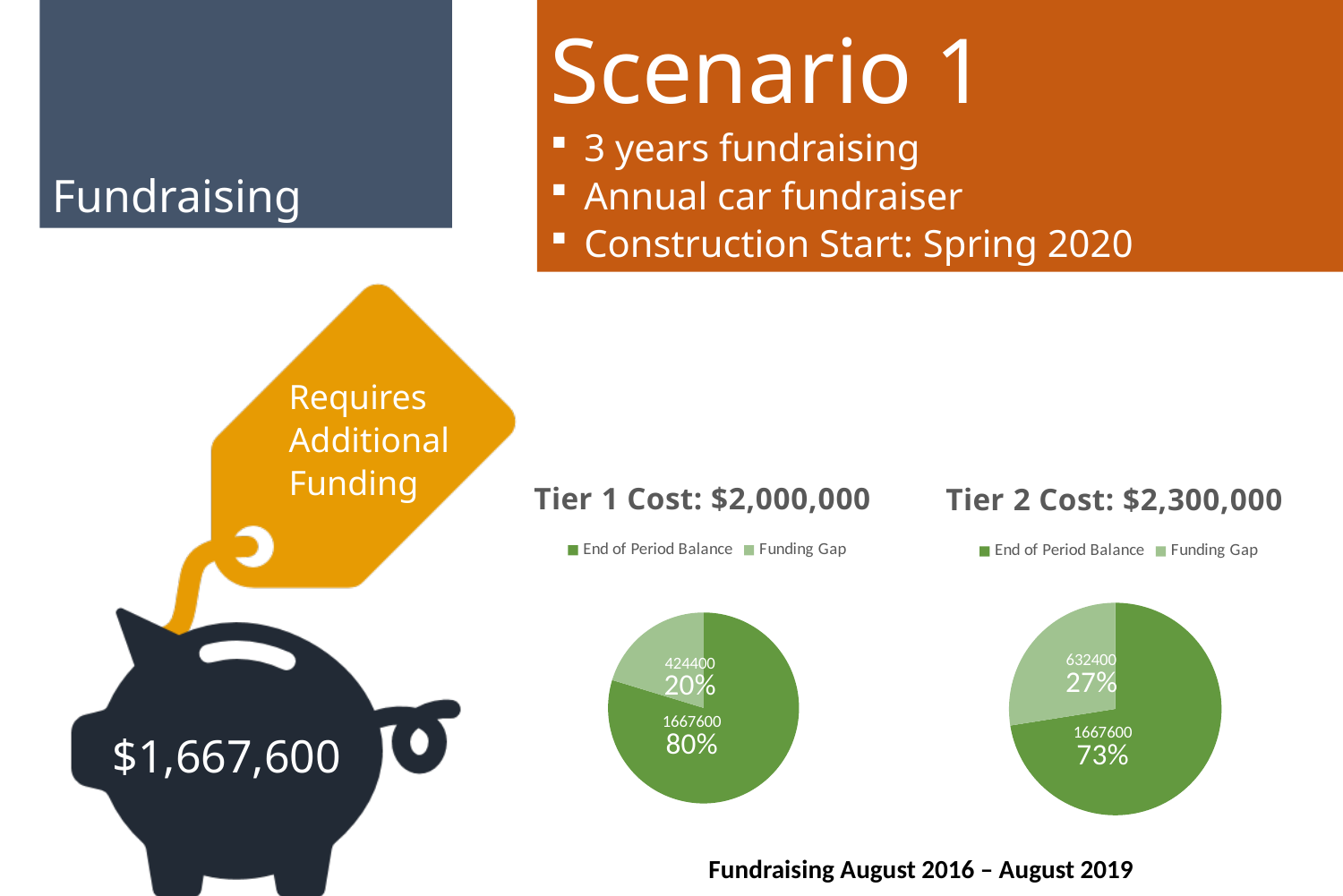
What kind of chart is the Tier 1 Cost: $2,000,000 chart? Pie chart In the Tier 2 Cost: $2,300,000 chart, which slice is the smallest? Funding Gap How many series does the legend of the Tier 2 Cost: $2,300,000 chart list? 2 What is the difference between the Funding Gap values in the Tier 2 Cost: $2,300,000 chart and the Tier 1 Cost: $2,000,000 chart? 208000 In the Tier 1 Cost: $2,000,000 chart, which slice is the largest? End of Period Balance In the Tier 2 Cost: $2,300,000 chart, what percentage share does the End of Period Balance slice have? 73% In the Tier 1 Cost: $2,000,000 chart, what is the value of the Funding Gap slice? 424400 Which chart has the larger Funding Gap value, Tier 1 Cost: $2,000,000 or Tier 2 Cost: $2,300,000? Tier 2 Cost: $2,300,000 In the Tier 1 Cost: $2,000,000 chart, what percentage share does the Funding Gap slice have? 20% In the Tier 1 Cost: $2,000,000 chart, what is the value of the End of Period Balance slice? 1667600 In the Tier 2 Cost: $2,300,000 chart, what is the value of the Funding Gap slice? 632400 In the Tier 2 Cost: $2,300,000 chart, what percentage share does the Funding Gap slice have? 27%